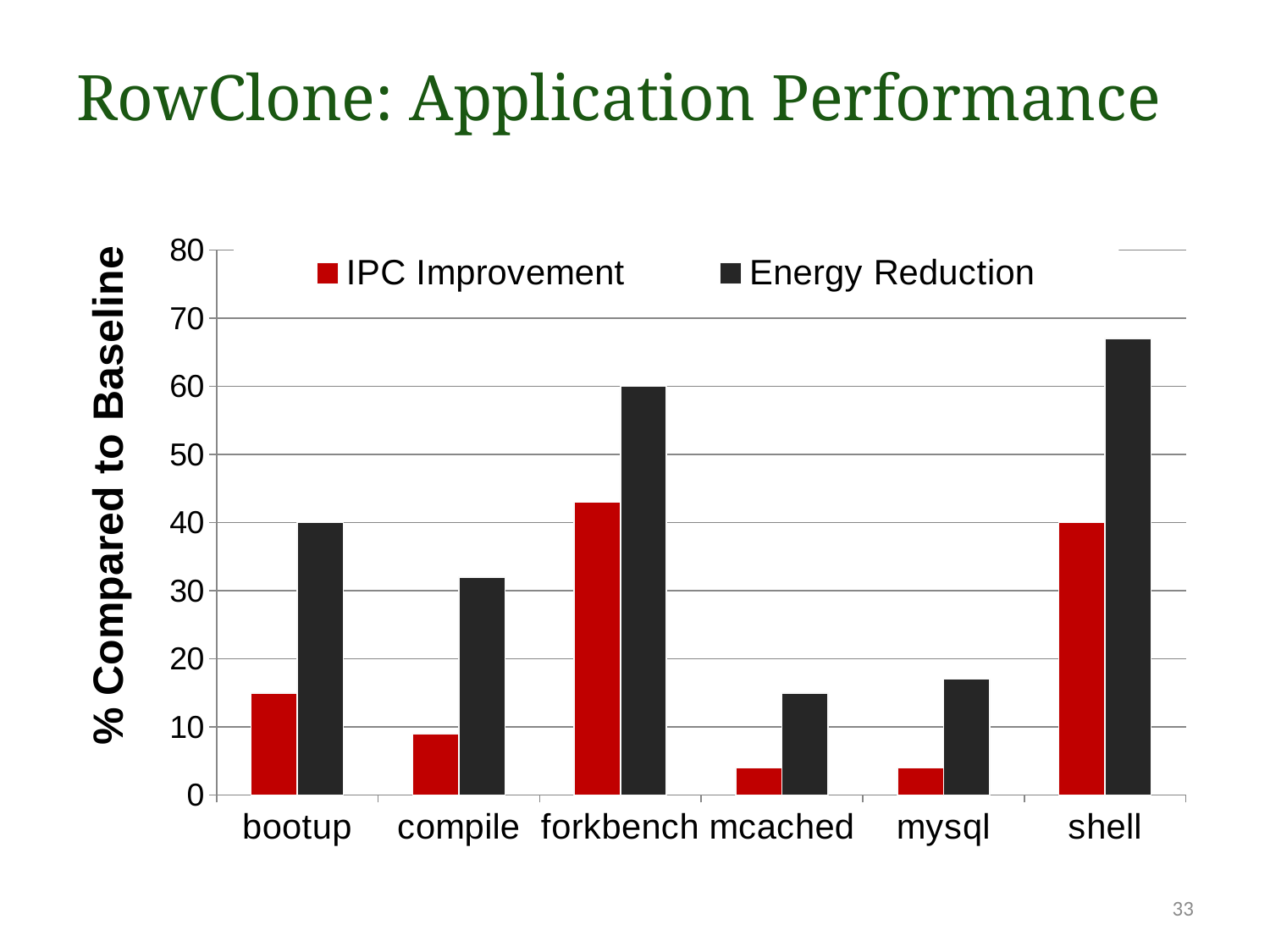
Is the Energy Reduction for compile greater or less than 30? greater Which application has the highest Energy Reduction? shell How many applications are shown on the x axis? 6 Is the IPC Improvement for mcached greater or less than 10? less Which is larger, the Energy Reduction for bootup or the Energy Reduction for compile? bootup How many series does the legend list? 2 What is the label of the y axis? % Compared to Baseline What type of chart is shown on the slide? bar chart Is the IPC Improvement for forkbench greater or less than 40? greater Which application has the highest IPC Improvement? forkbench Which is larger, the IPC Improvement for bootup or the IPC Improvement for compile? bootup